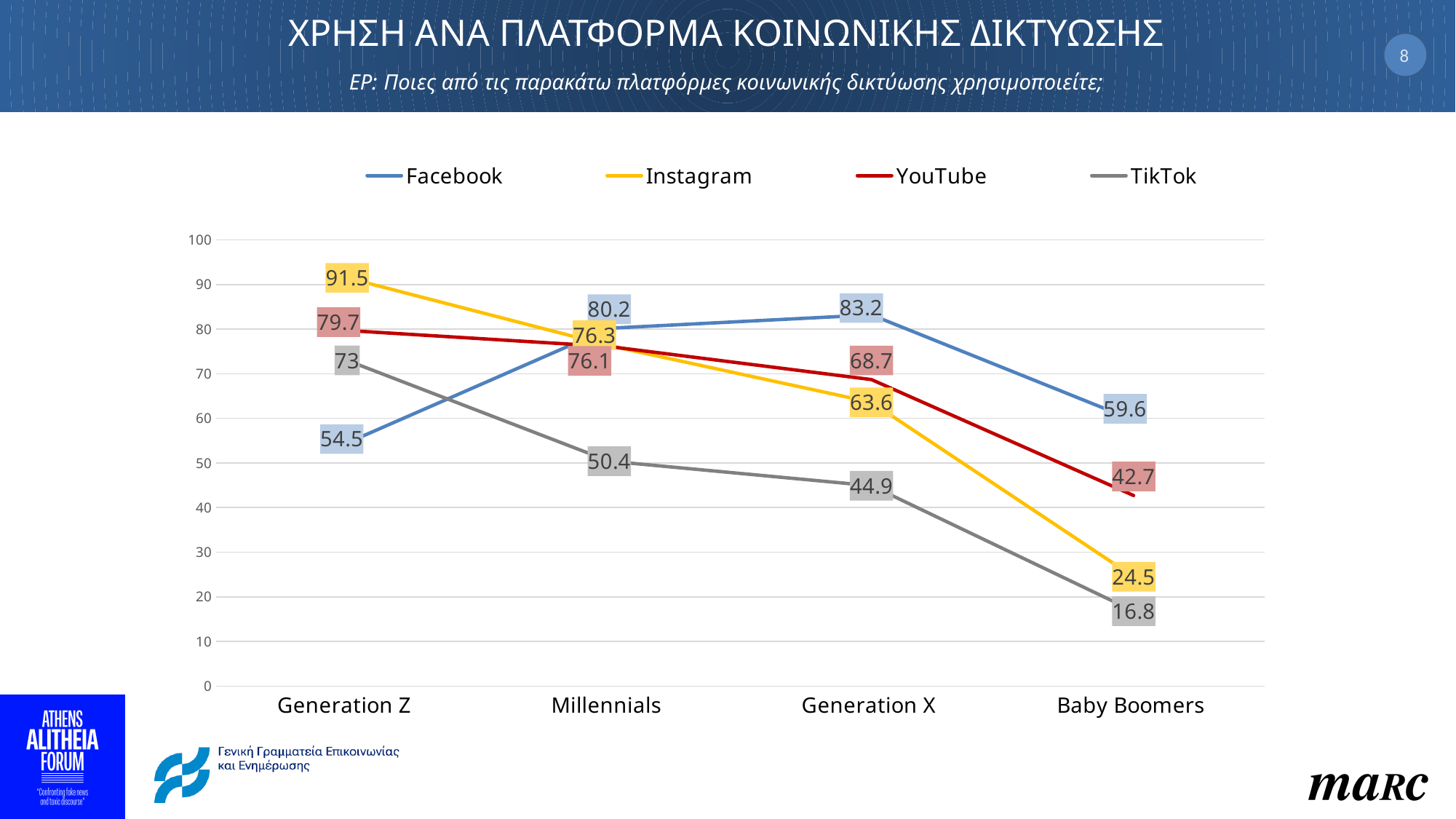
What is the TikTok value for Millennials? 50.4 For which category is the Facebook value highest? Generation X Does the Instagram series rise or fall from Generation Z to Baby Boomers? fall Which is larger for Generation Z: the YouTube value or the Facebook value? YouTube For which category is the TikTok value lowest? Baby Boomers How many series does the legend list? 4 What is the YouTube value for Generation X? 68.7 What is the difference between the Instagram and TikTok values for Baby Boomers? 7.7 What kind of chart is shown on the slide? line chart How many categories are shown on the x axis? 4 What is the Facebook value for Baby Boomers? 59.6 What is the Instagram value for Generation Z? 91.5